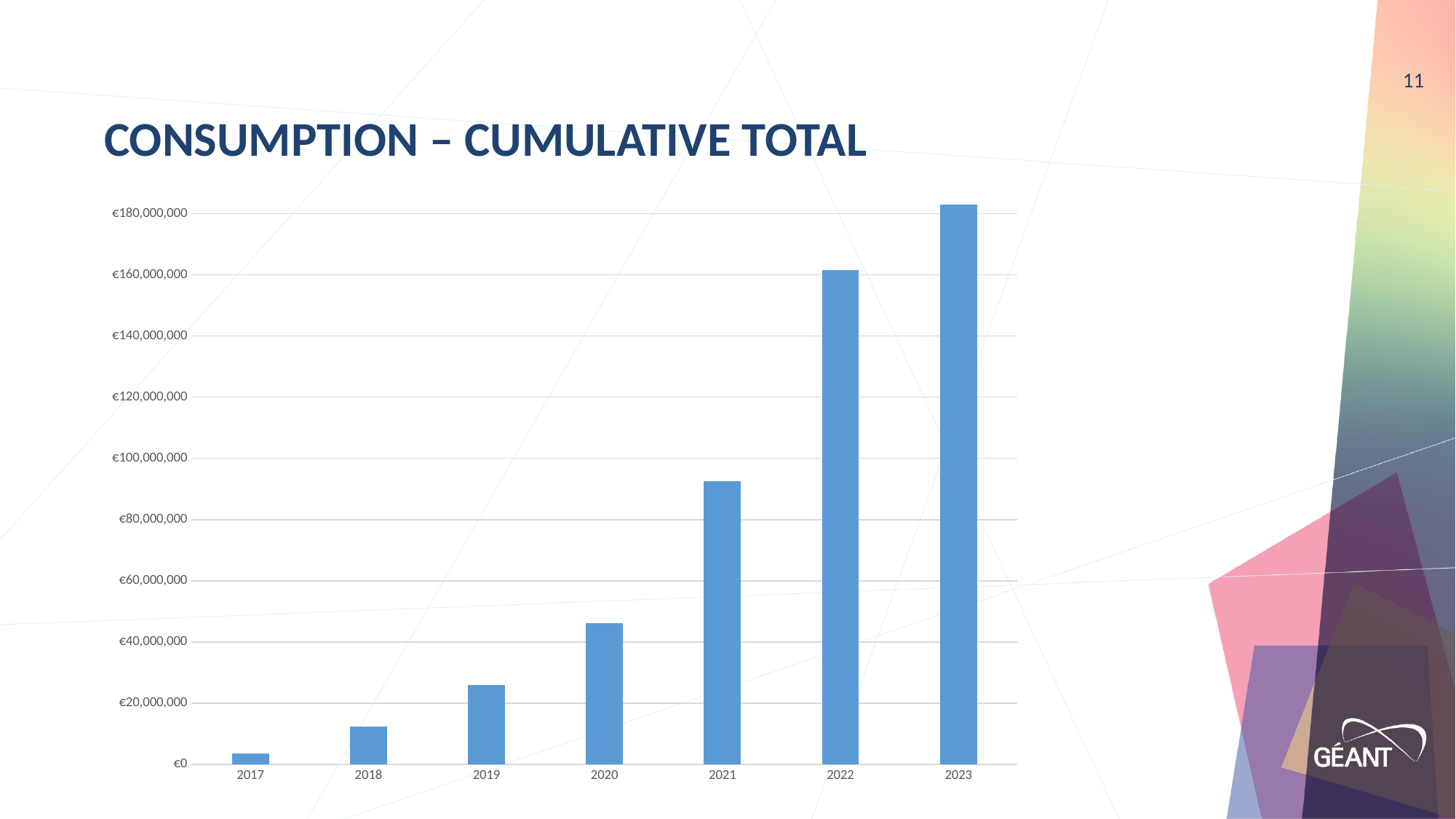
What is the title of the chart? CONSUMPTION – CUMULATIVE TOTAL How many years are shown on the x axis? 7 Which year has the highest cumulative total? 2023 Is the value for 2020 greater or less than €40,000,000? greater Which is larger, the value for 2021 or the value for 2022? 2022 Do the values rise or fall from 2017 to 2023? rise Is the value for 2021 greater or less than €100,000,000? less Is the value for 2023 greater or less than €180,000,000? greater Which year has the lowest cumulative total? 2017 What kind of chart is shown on the slide? bar chart